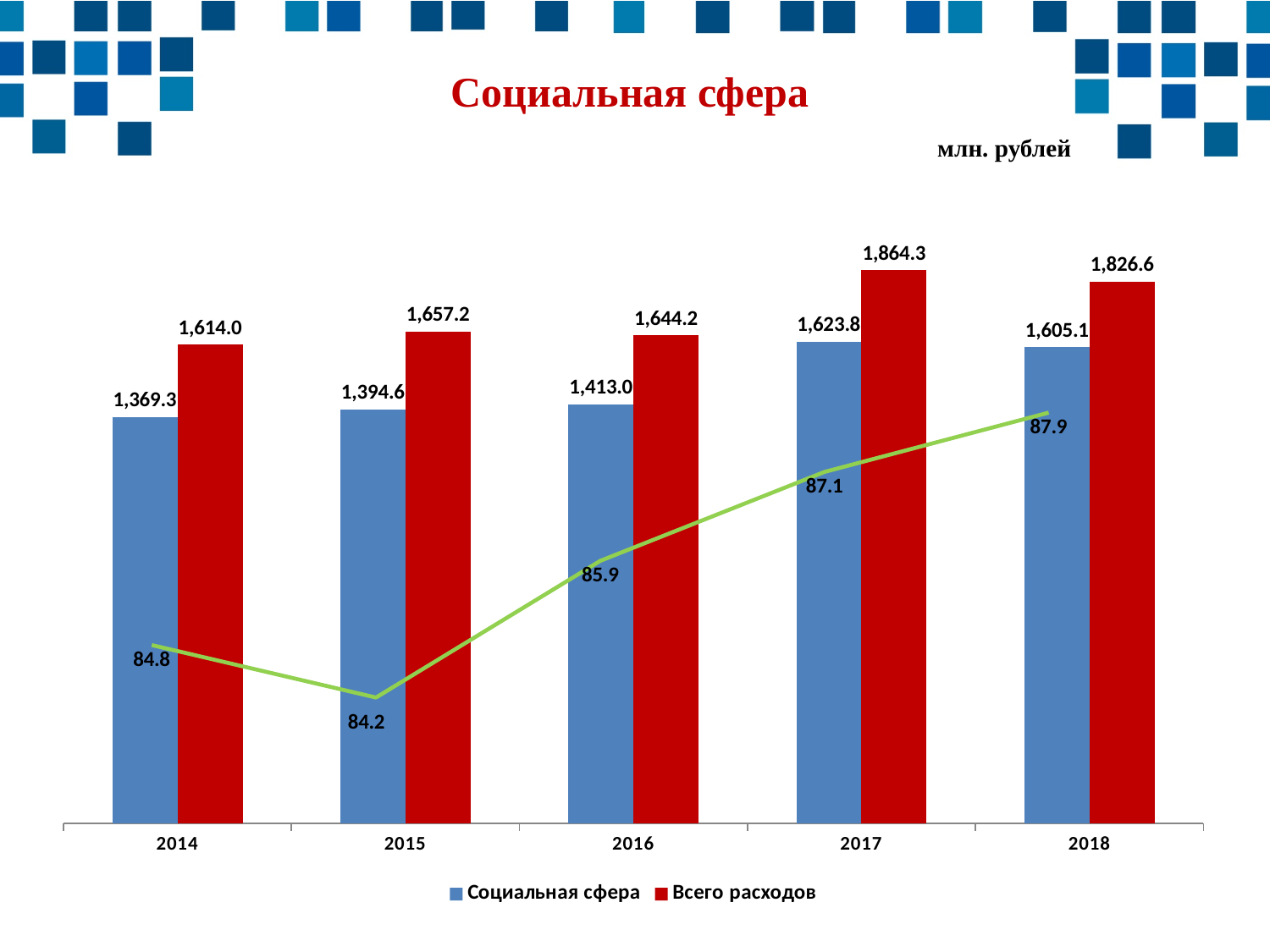
What is the value of Всего расходов in 2017? 1,864.3 What unit is stated for the chart values? млн. рублей In which year is Всего расходов highest? 2017 In which year is Социальная сфера lowest? 2014 How many series does the legend list? 2 How many years are shown on the x axis? 5 What is the difference between Всего расходов and Социальная сфера in 2014? 244.7 What is the value of Социальная сфера in 2018? 1,605.1 Which is larger: Социальная сфера in 2017 or Социальная сфера in 2018? Социальная сфера in 2017 What is the value of Социальная сфера in 2016? 1,413.0 Does the green line rise or fall from 2015 to 2018? rise What value does the green line show for 2015? 84.2